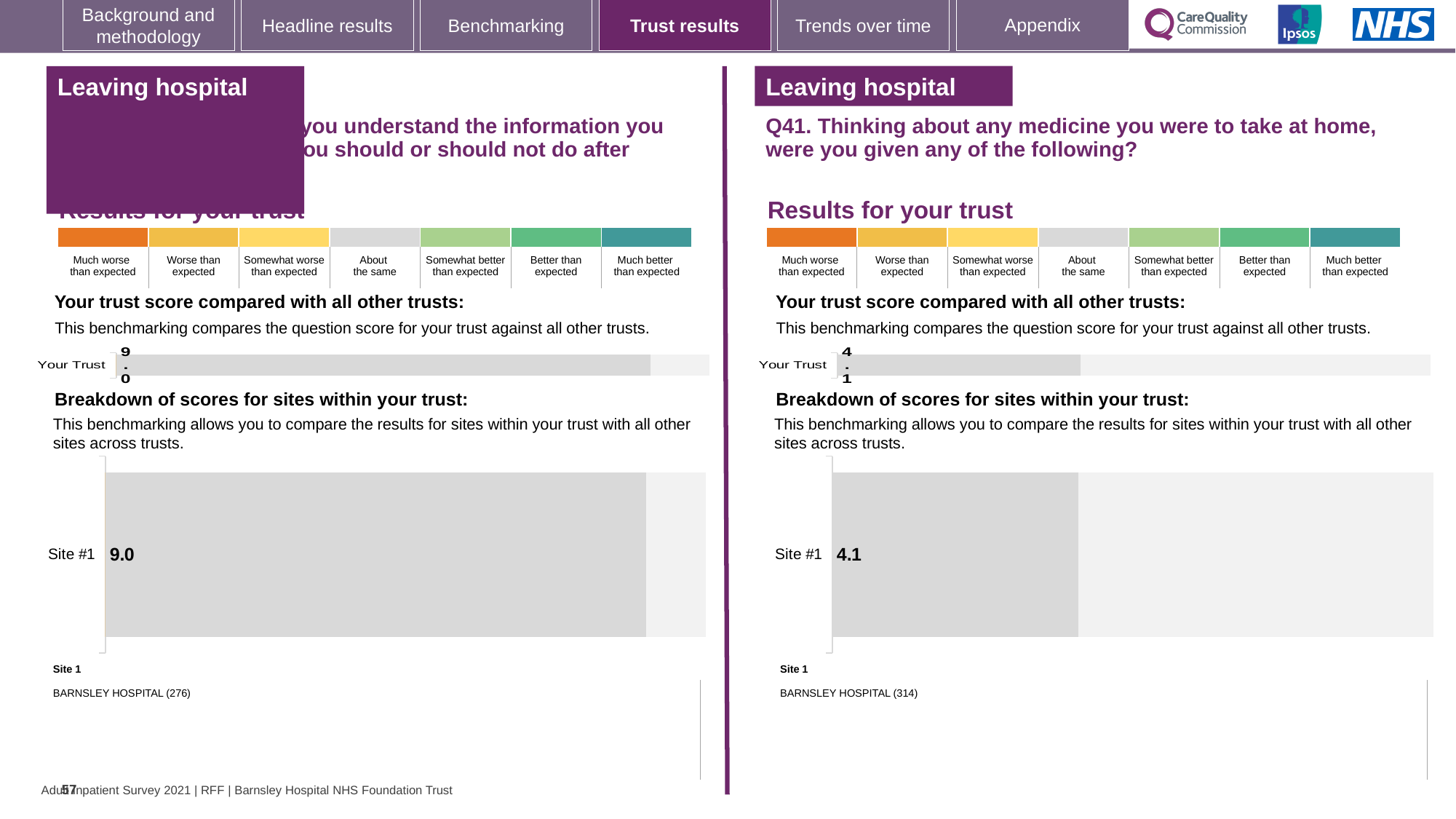
Which is larger: the Site #1 score on the left-hand chart or the Site #1 score on the right-hand chart (Q41)? Left-hand chart (9.0) On the right-hand chart (Q41), what is the score shown for Site #1? 4.1 What is the difference between the Site #1 score on the left-hand chart and the Site #1 score on the right-hand chart (Q41)? 4.9 On the right-hand chart (Q41), what is the score shown for Your Trust? 4.1 On the left-hand chart, what is the score shown for Site #1? 9.0 On the right-hand chart (Q41), which site is listed as Site 1? BARNSLEY HOSPITAL (314) On the left-hand chart, which site is listed as Site 1? BARNSLEY HOSPITAL (276) How many sites are shown in the breakdown of scores on the left-hand chart? 1 What kind of chart is used to show the breakdown of scores for sites within your trust on the right-hand side (Q41)? Bar chart How many sites are shown in the breakdown of scores on the right-hand chart (Q41)? 1 On the left-hand chart, what is the score shown for Your Trust? 9.0